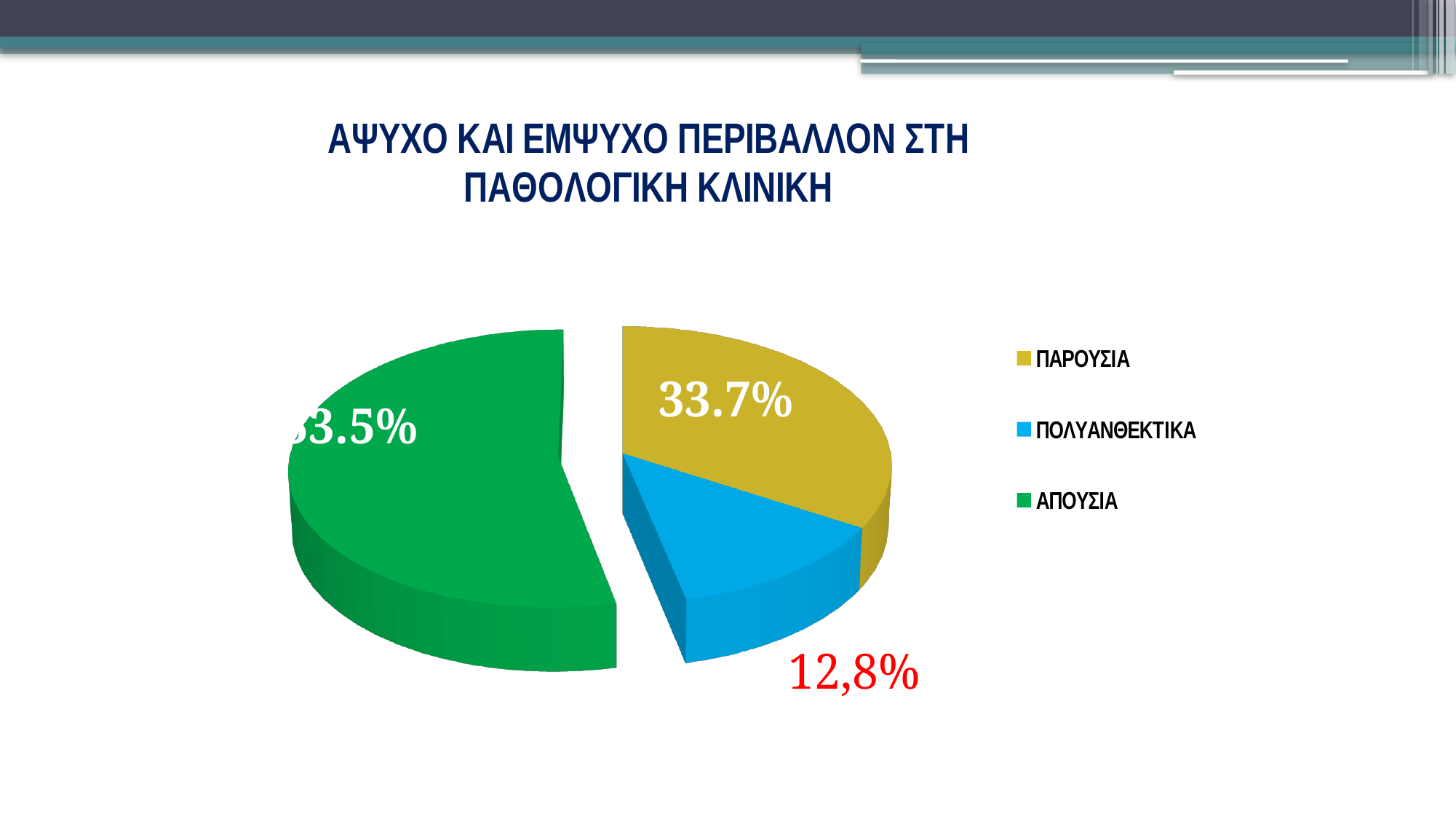
What is the difference in percentage points between the ΠΑΡΟΥΣΙΑ slice and the ΠΟΛΥΑΝΘΕΚΤΙΚΑ slice? 20.9 Is the share of the ΑΠΟΥΣΙΑ slice greater or less than 50%? greater How many entries does the legend list? 3 Which category has the smallest slice of the pie? ΠΟΛΥΑΝΘΕΚΤΙΚΑ What colour is the ΑΠΟΥΣΙΑ slice? green Which category has the largest slice of the pie? ΑΠΟΥΣΙΑ What percentage is shown for the ΠΑΡΟΥΣΙΑ slice? 33.7% What kind of chart is shown on the slide? pie chart What is the title of the slide above the chart? ΑΨΥΧΟ ΚΑΙ ΕΜΨΥΧΟ ΠΕΡΙΒΑΛΛΟΝ ΣΤΗ ΠΑΘΟΛΟΓΙΚΗ ΚΛΙΝΙΚΗ What percentage is shown for the ΠΟΛΥΑΝΘΕΚΤΙΚΑ slice? 12,8% Which slice is larger, ΠΑΡΟΥΣΙΑ or ΠΟΛΥΑΝΘΕΚΤΙΚΑ? ΠΑΡΟΥΣΙΑ How many slices does the pie chart have? 3